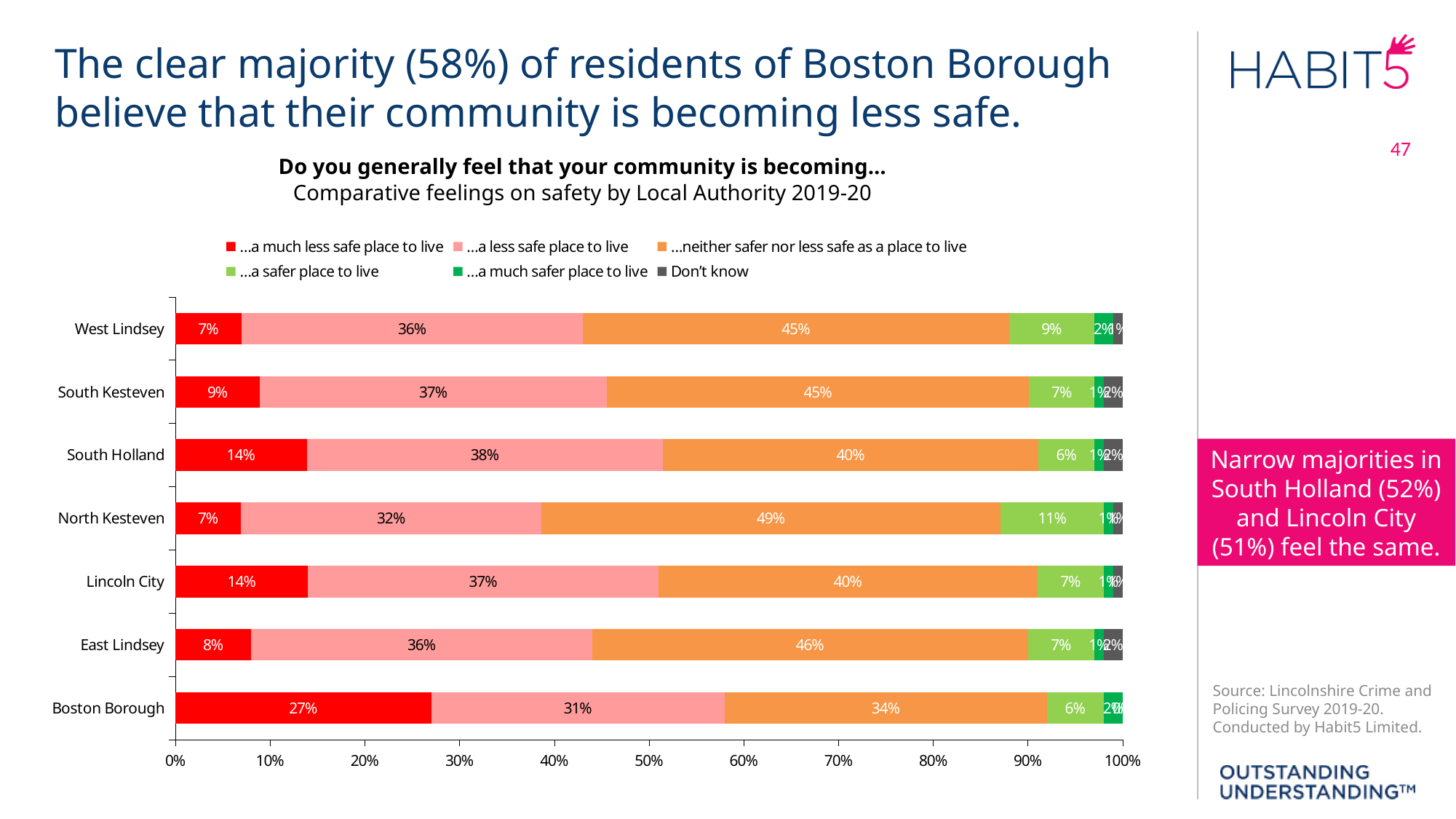
What percentage of South Holland residents said their community is becoming a less safe place to live? 38% What is the subtitle of the chart? Comparative feelings on safety by Local Authority 2019-20 What percentage of North Kesteven residents said their community is becoming neither safer nor less safe as a place to live? 49% Which is larger: the 'a safer place to live' share for North Kesteven or for West Lindsey? North Kesteven Is the combined 'much less safe' and 'less safe' share for Boston Borough greater or less than 50%? greater How many series does the legend list? 6 What kind of chart is shown on the slide? Stacked bar chart Which local authority has the highest share of residents saying their community is becoming a much less safe place to live? Boston Borough What is the difference between the 'much less safe' percentages for Boston Borough and South Kesteven? 18 percentage points How many local authorities are shown on the chart? 7 Which local authority has the lowest share of residents saying their community is becoming neither safer nor less safe as a place to live? Boston Borough What percentage of Boston Borough residents said their community is becoming a much less safe place to live? 27%